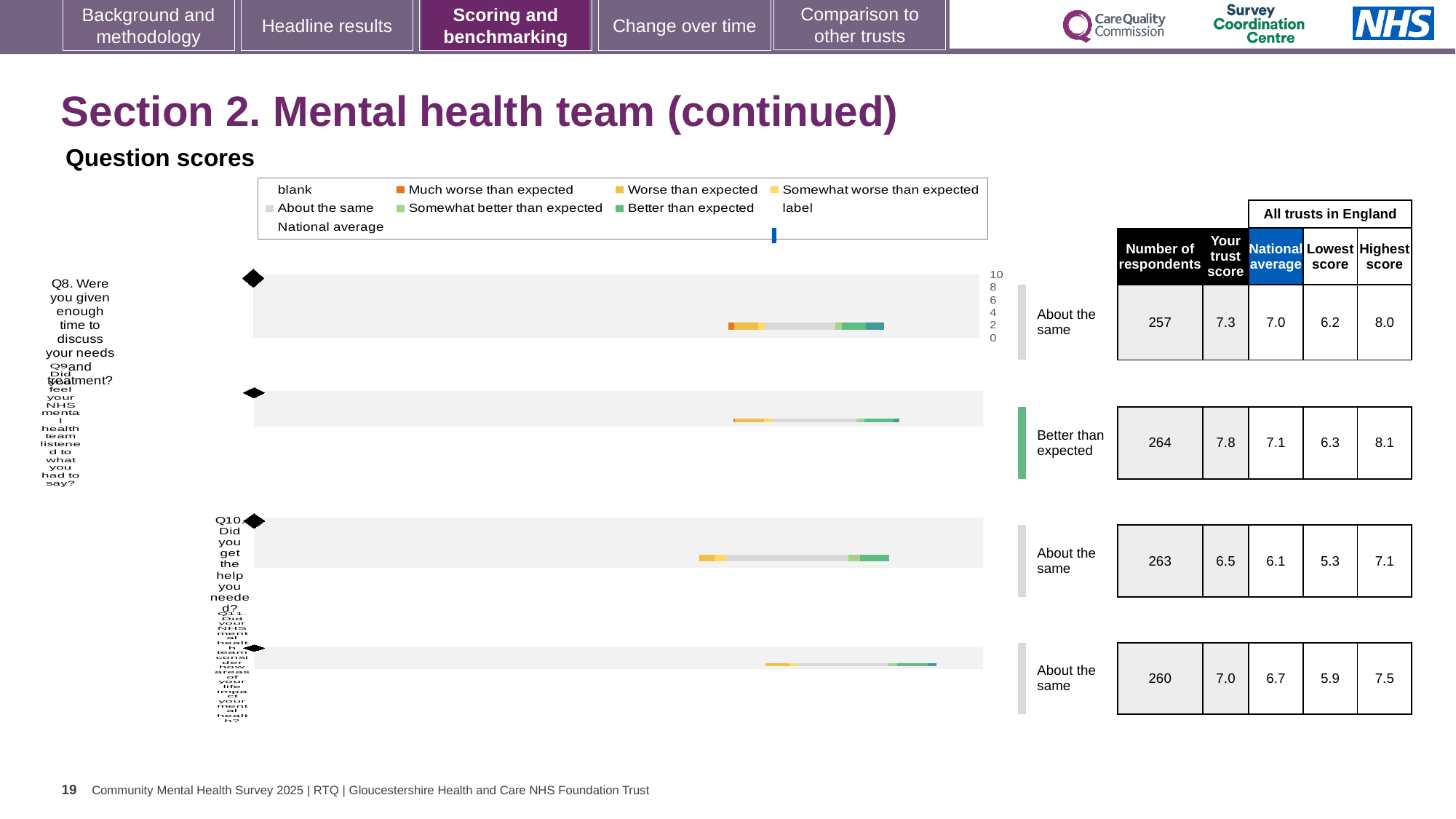
For the Q10 chart, what is the difference between the highest score (7.1) and the lowest score (5.3)? 1.8 For the Q11 chart (bottom chart), what is the highest score among all trusts in England? 7.5 What kind of chart is used to show the Q8 benchmark result? bar chart For the Q10 chart (Did you get the help you needed?), what is the lowest score among all trusts in England? 5.3 Across the four question charts, which question has the highest 'Your trust score'? Q9 (7.8) For the Q9 chart, which is larger: the trust score or the national average? the trust score (7.8) For the Q8 chart, how many respondents are listed? 257 What benchmark category label is shown next to the Q9 chart? Better than expected Across the four question charts, which question has the fewest respondents? Q8 (257) How many question charts (Q8 to Q11) are shown on the slide? 4 For the Q8 chart (Were you given enough time to discuss your needs and treatment?), what is the 'Your trust score' shown in the table? 7.3 For the Q9 chart (second from top), what is the national average score? 7.1